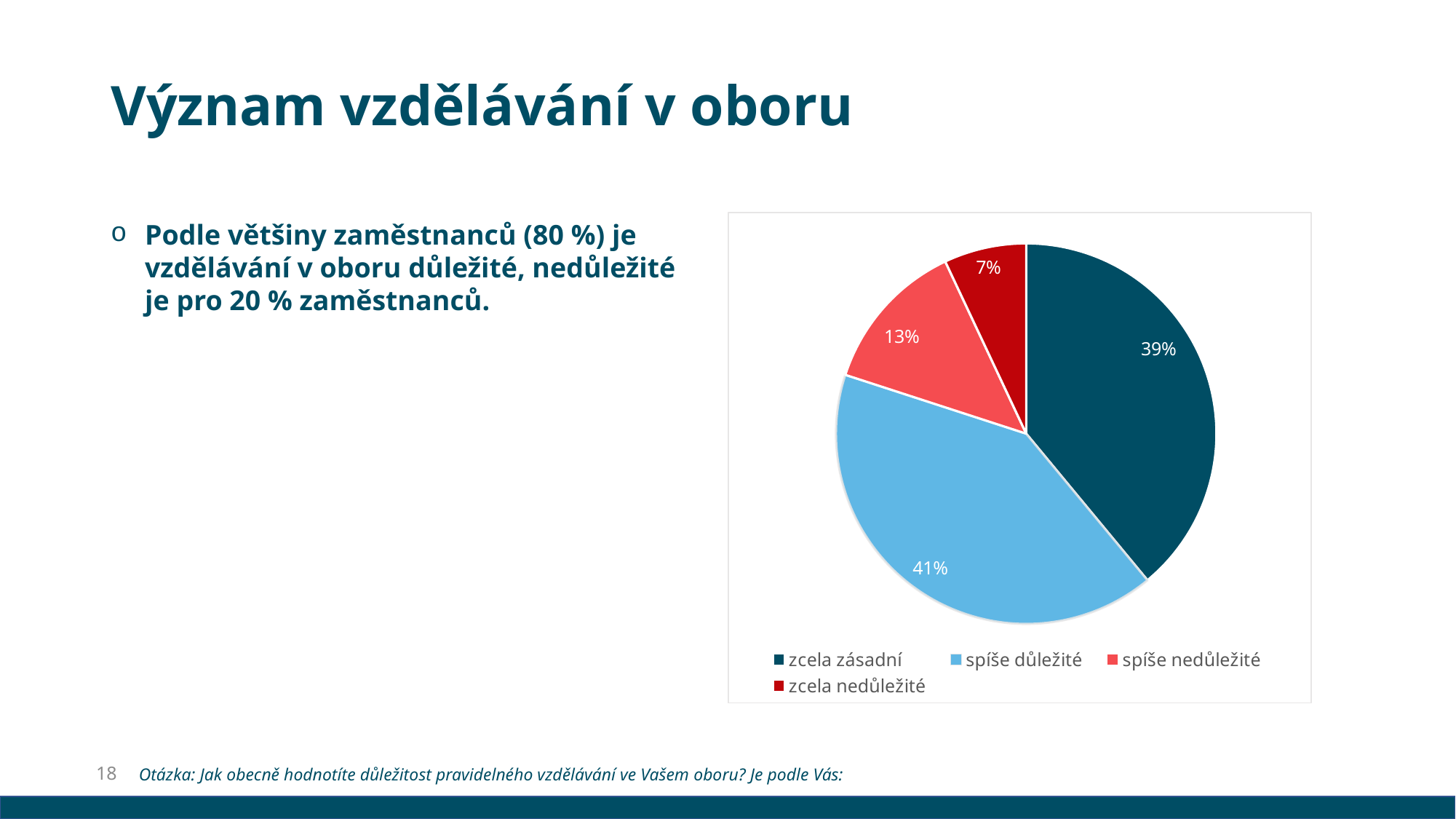
Which category has the largest slice of the pie? spíše důležité What is the difference in percentage points between "spíše nedůležité" and "zcela nedůležité"? 6 What type of chart is shown on the slide? pie chart Which is larger: the slice for "spíše nedůležité" or the slice for "zcela nedůležité"? spíše nedůležité Which category has the smallest slice of the pie? zcela nedůležité What share of the pie does "spíše důležité" represent? 41% What colour is the slice for "zcela nedůležité"? dark red What share of the pie does "zcela nedůležité" represent? 7% What share of the pie does "spíše nedůležité" represent? 13% What is the difference in percentage points between "spíše důležité" and "zcela zásadní"? 2 What share of the pie does "zcela zásadní" represent? 39% How many slices does the pie chart have? 4